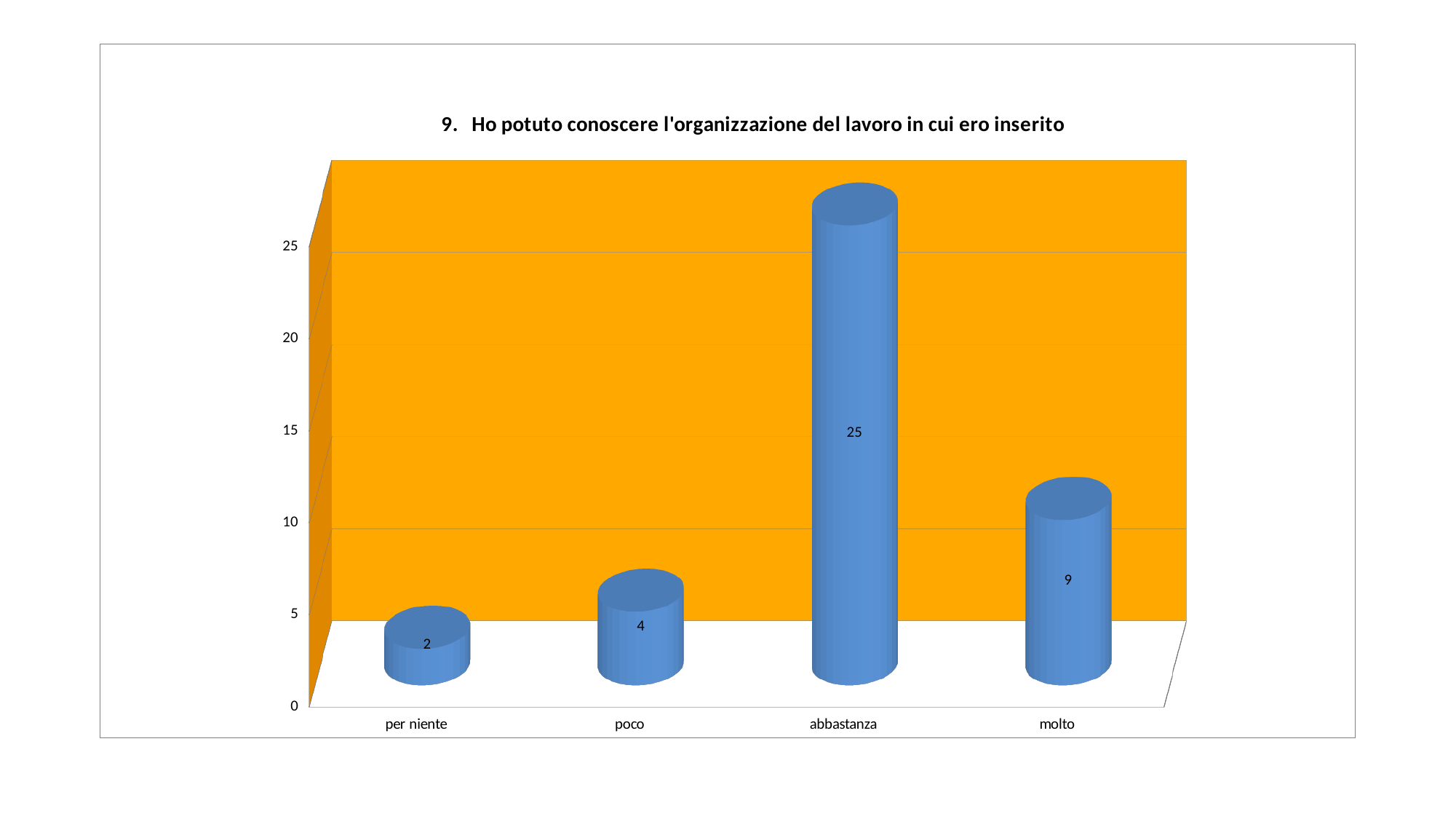
Which category has the lowest value? per niente Which category has the highest value? abbastanza What kind of chart is shown on the slide? bar chart What is the difference between the values for "abbastanza" and "molto"? 16 How many categories are shown on the x axis? 4 What is the value for "per niente"? 2 What is the value for "poco"? 4 Which is larger, the value for "poco" or the value for "molto"? molto What is the value for "molto"? 9 Is the value for "molto" greater or less than 10? less What is the value for "abbastanza"? 25 What is the title of the chart? 9. Ho potuto conoscere l'organizzazione del lavoro in cui ero inserito